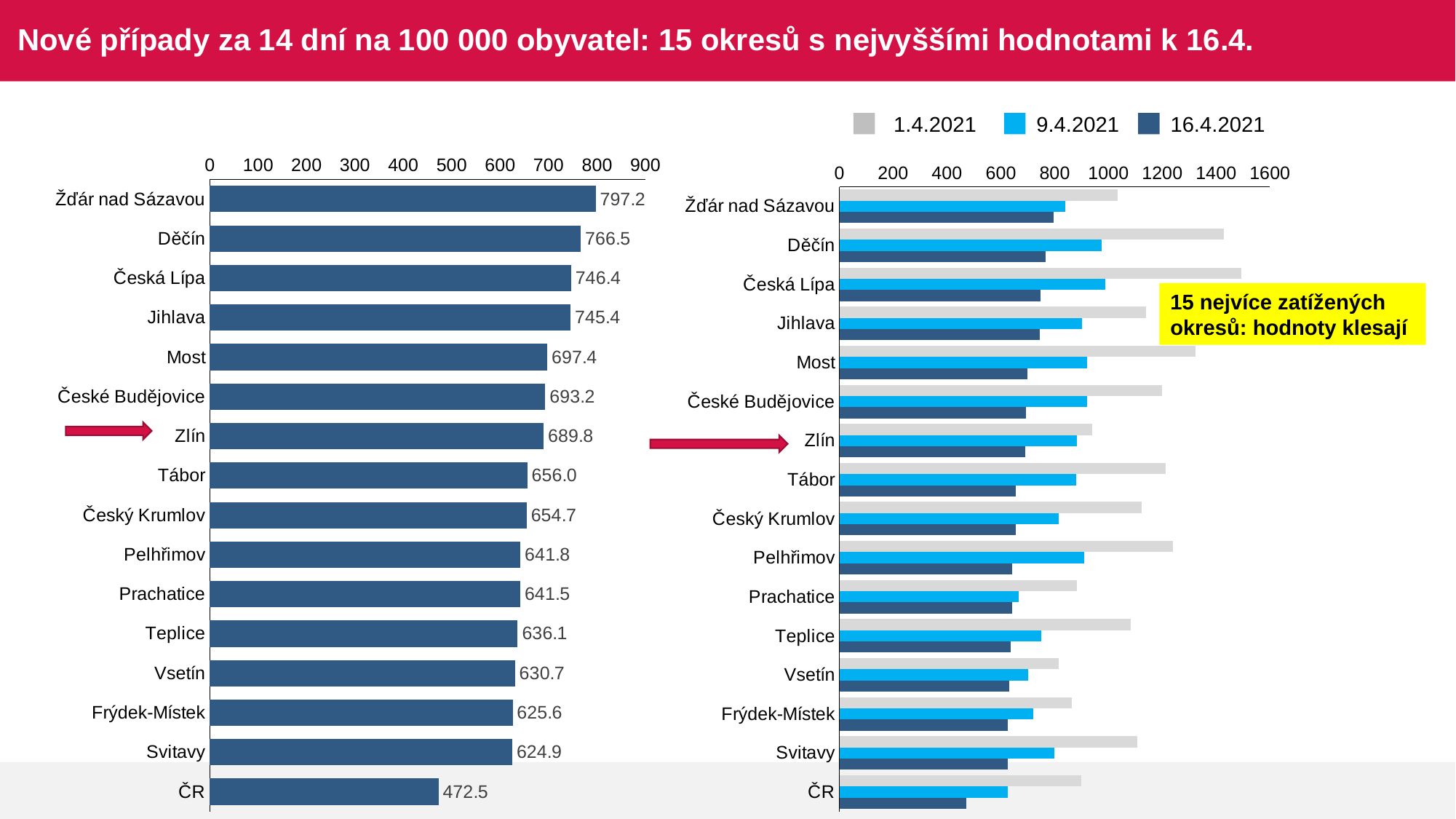
In the left chart, what is the difference between the values for Žďár nad Sázavou and Děčín? 30.7 In the right chart, is the value for ČR on 16.4.2021 greater or less than 600? less In the left chart, what is the value for Zlín? 689.8 In the left chart, what is the value for ČR? 472.5 In the left chart, which category has the lowest value? ČR In the left chart, what is the value for Žďár nad Sázavou? 797.2 In the right chart, is the value for Děčín on 1.4.2021 greater or less than 1200? greater In the left chart, which is larger, the value for Most or the value for Tábor? Most What kind of chart is the right chart? bar chart In the left chart, which category has the highest value? Žďár nad Sázavou How many series does the legend of the right chart list? 3 How many categories are shown in the left chart? 16